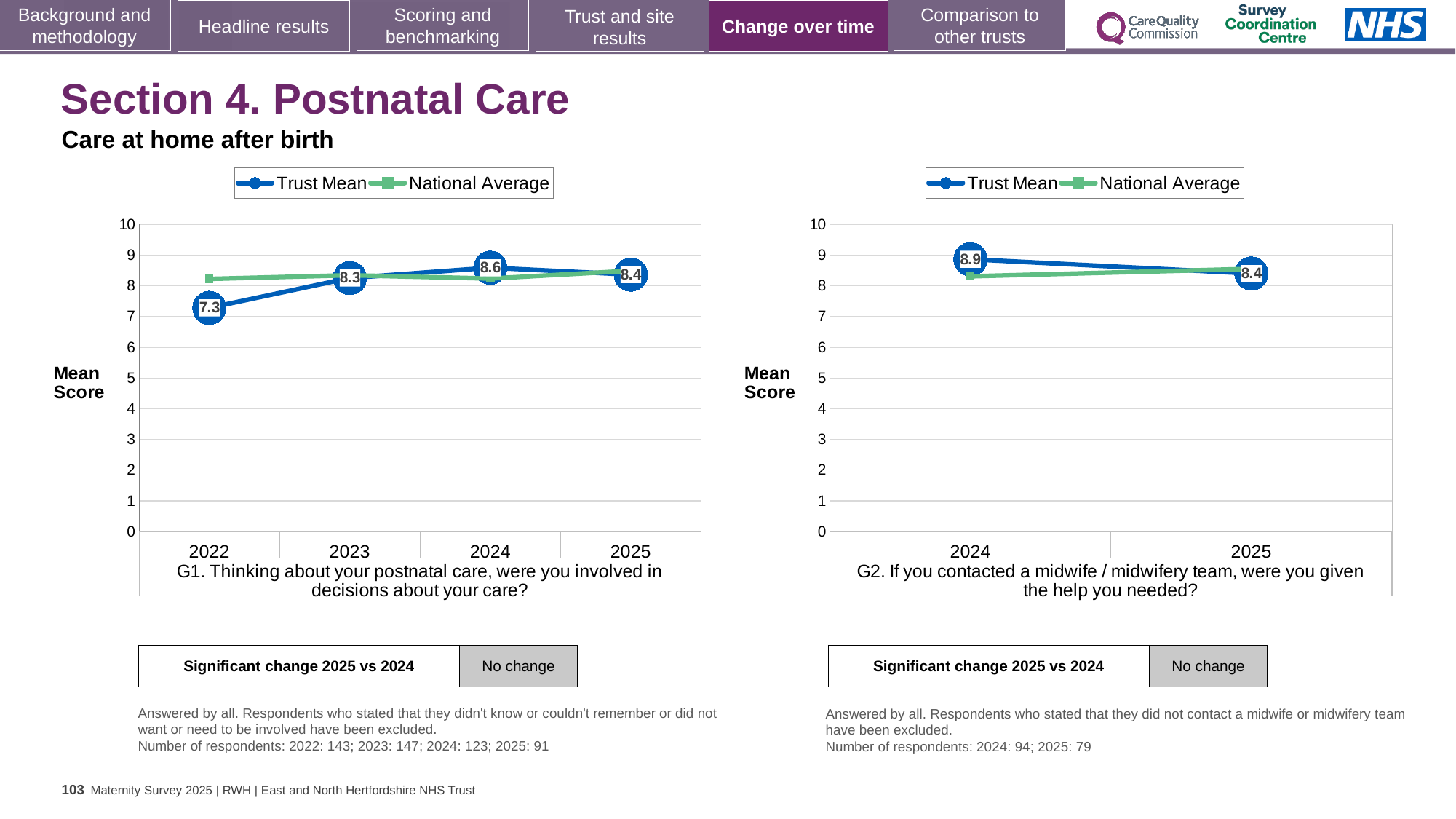
In the left chart (G1), what is the Trust Mean score for 2024? 8.6 In the left chart (G1), which year has the highest Trust Mean score? 2024 In the right chart (G2), what is the Trust Mean score for 2025? 8.4 In the right chart (G2), what is the Trust Mean score for 2024? 8.9 How many series does the legend of the right chart (G2) list? 2 In the right chart (G2), what is the difference between the Trust Mean scores for 2024 and 2025? 0.5 In the left chart (G1), which year has the lowest Trust Mean score? 2022 In the left chart (G1), is the National Average value for 2022 greater or less than 7? greater In the left chart (G1), what is the difference between the Trust Mean scores for 2023 and 2022? 1.0 In the right chart (G2), is the Trust Mean score higher in 2024 or 2025? 2024 How many years are shown on the x axis of the left chart (G1)? 4 In the left chart (G1), what is the Trust Mean score for 2022? 7.3